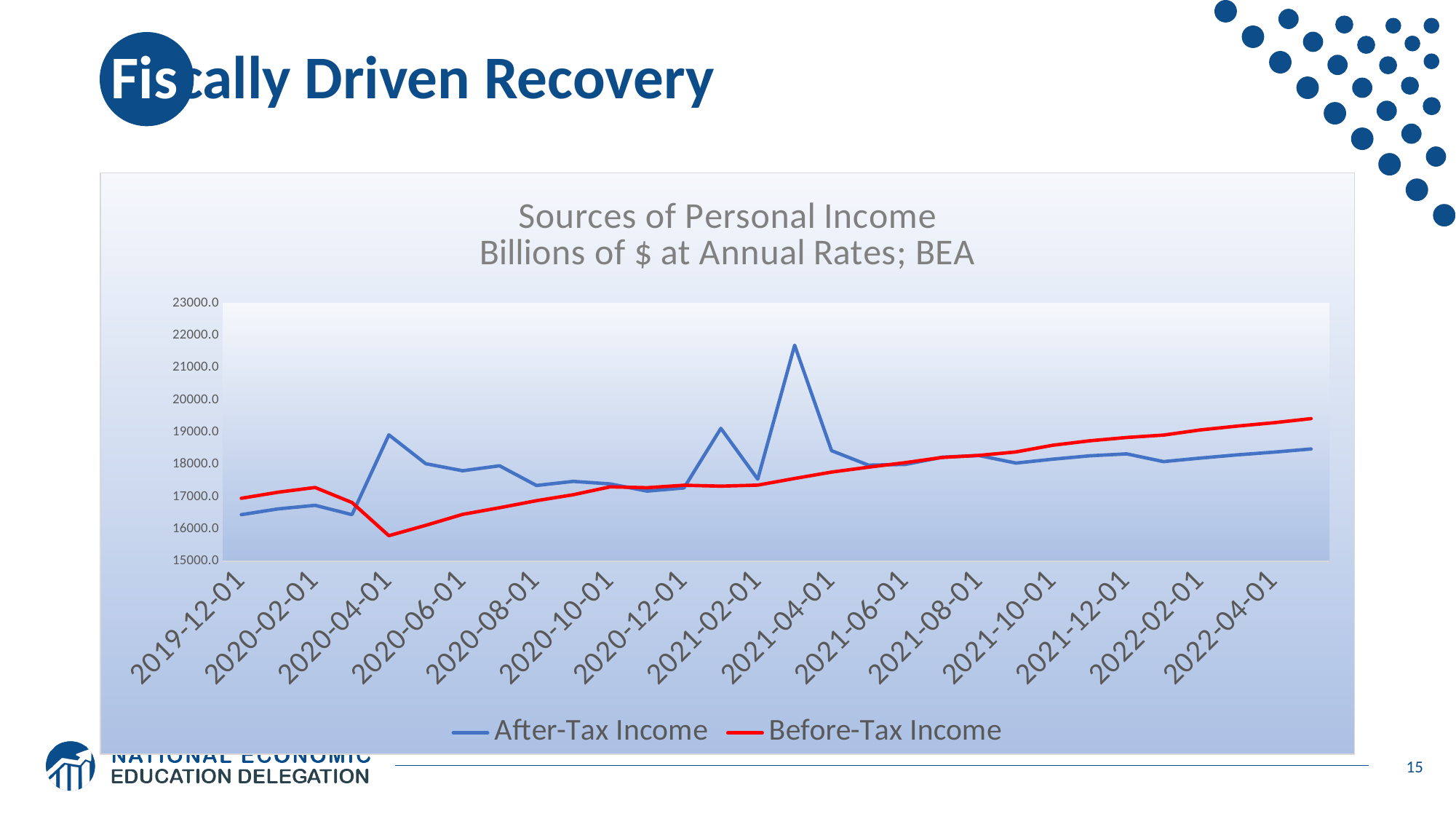
Is the value of Before-Tax Income at 2022-04-01 greater or less than 19000? greater At 2020-04-01, which series has the higher value, After-Tax Income or Before-Tax Income? After-Tax Income How many series does the legend list? 2 How many date labels are shown on the x axis? 15 Is the value of After-Tax Income at 2022-04-01 greater or less than 19000? less Does Before-Tax Income rise or fall from 2020-04-01 to 2022-04-01? rise Is the value of Before-Tax Income at 2020-04-01 greater or less than 16000? less What kind of chart is shown on the slide? line chart What are the two series named in the legend? After-Tax Income and Before-Tax Income At 2022-04-01, which series has the higher value, After-Tax Income or Before-Tax Income? Before-Tax Income What is the title of the chart? Sources of Personal Income Billions of $ at Annual Rates; BEA